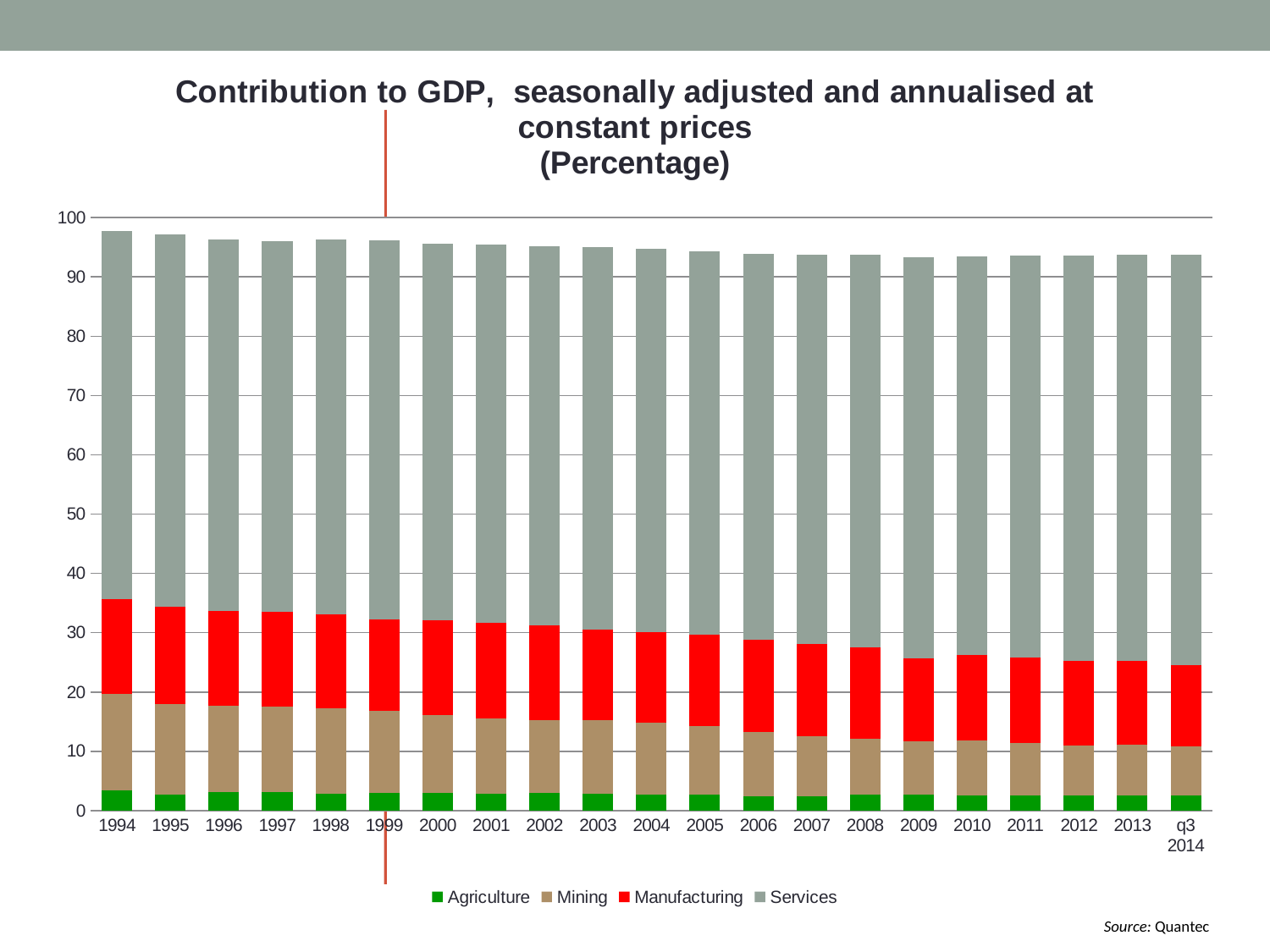
Do the total bar heights rise or fall from 1994 to q3 2014? fall Which series contributes the largest share of the bar in 2000? Services What colour represents Manufacturing in the chart? Red Is the total height of the 1994 bar greater or less than 90? greater Which series is listed last in the legend? Services What kind of chart is shown on the slide? Stacked bar chart In 2013, which is larger: the Services segment or the Manufacturing segment? Services In 1994, which is larger: the Mining segment or the Agriculture segment? Mining How many categories (time periods) are shown along the x axis? 21 Which series contributes the smallest share of the bar in 2010? Agriculture Is the Agriculture value for 1994 greater or less than 10? less How many series does the legend list? 4